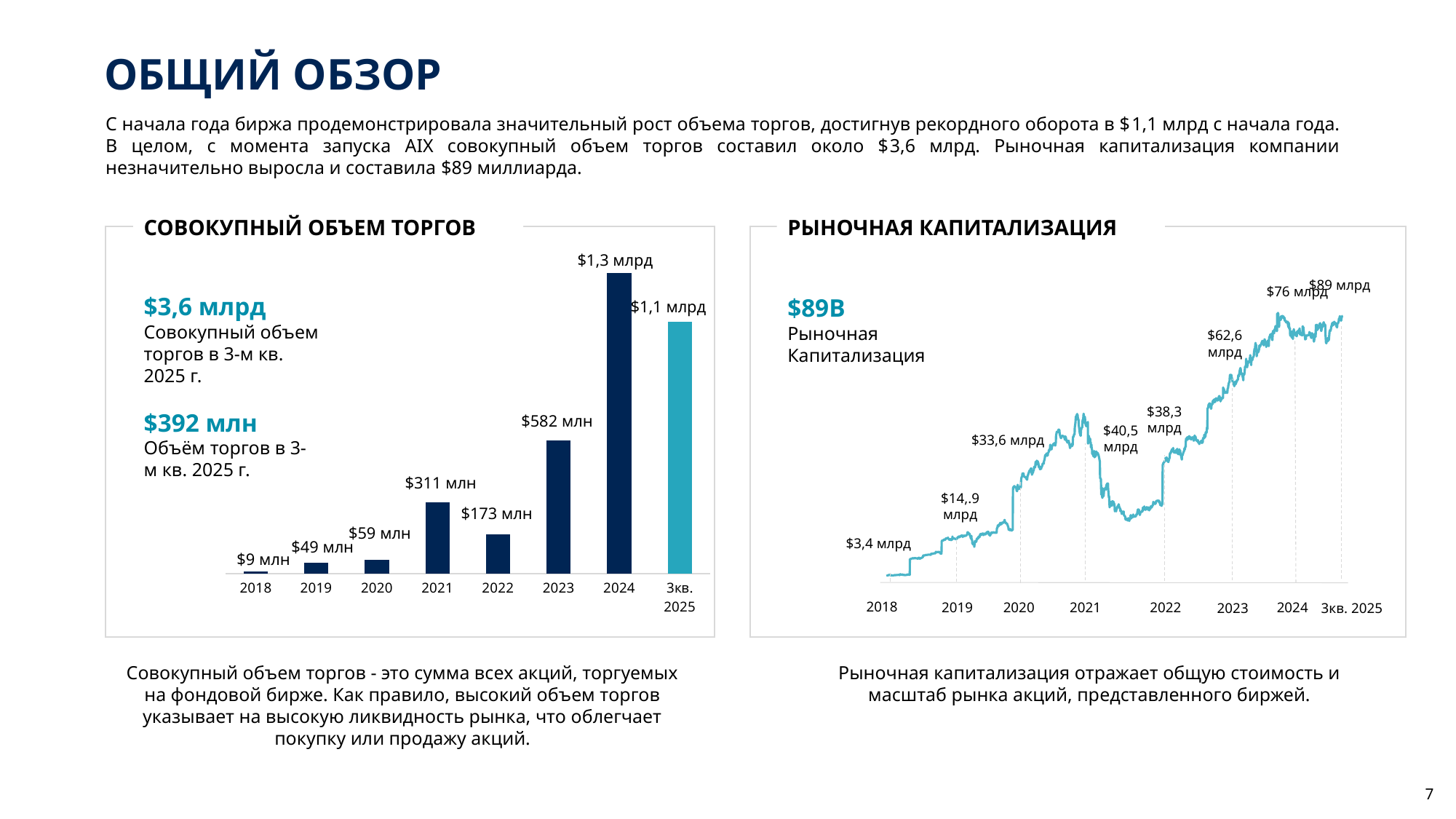
In the chart titled "СОВОКУПНЫЙ ОБЪЕМ ТОРГОВ", which is larger, the value for 2021 or the value for 2022? 2021 In the chart titled "СОВОКУПНЫЙ ОБЪЕМ ТОРГОВ", what is the value for 2023? $582 млн In the chart titled "РЫНОЧНАЯ КАПИТАЛИЗАЦИЯ", what value is labelled for 3кв. 2025? $89 млрд In the chart titled "СОВОКУПНЫЙ ОБЪЕМ ТОРГОВ", which category has the lowest value? 2018 In the chart titled "РЫНОЧНАЯ КАПИТАЛИЗАЦИЯ", does the value generally rise or fall from 2018 to 3кв. 2025? Rise In the chart titled "СОВОКУПНЫЙ ОБЪЕМ ТОРГОВ", how many categories are shown on the x axis? 8 In the chart titled "СОВОКУПНЫЙ ОБЪЕМ ТОРГОВ", which year has the highest value? 2024 In the chart titled "РЫНОЧНАЯ КАПИТАЛИЗАЦИЯ", what value is labelled for 2020? $33,6 млрд What kind of chart is the chart titled "СОВОКУПНЫЙ ОБЪЕМ ТОРГОВ"? Bar chart In the chart titled "СОВОКУПНЫЙ ОБЪЕМ ТОРГОВ", what is the difference between the values for 2023 and 2022? $409 млн In the chart titled "СОВОКУПНЫЙ ОБЪЕМ ТОРГОВ", what is the value for 2021? $311 млн What kind of chart is the chart titled "РЫНОЧНАЯ КАПИТАЛИЗАЦИЯ"? Line chart